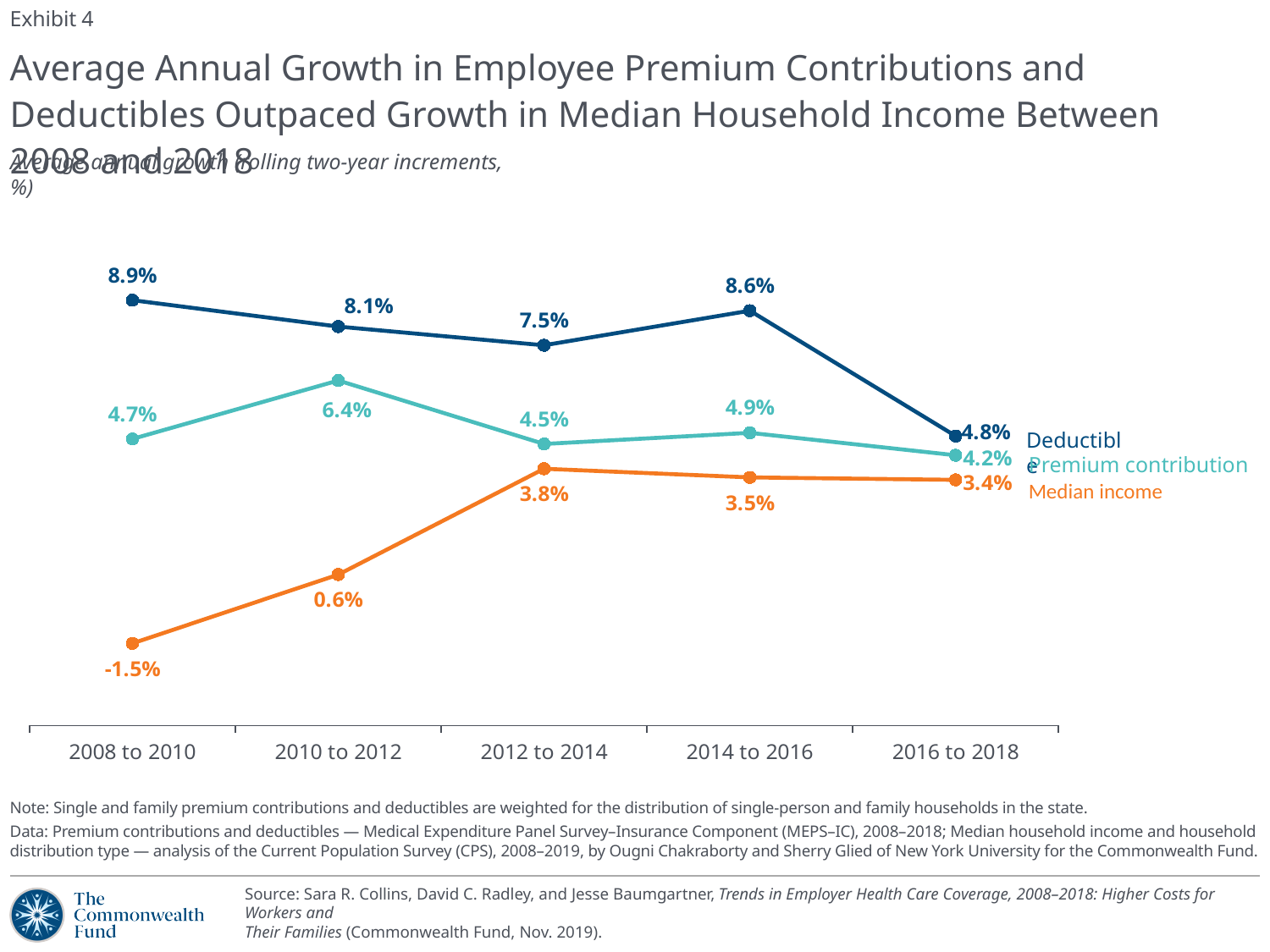
What is the difference between the Deductible value and the Median income value in 2016 to 2018? 1.4% In which period is the Deductible value lowest? 2016 to 2018 What is the value for Deductible in 2008 to 2010? 8.9% What is the value for Median income in 2010 to 2012? 0.6% What kind of chart is shown on the slide? Line chart How many series does the chart show? 3 In which period is the Premium contribution value highest? 2010 to 2012 Which is larger in 2012 to 2014, Premium contribution or Median income? Premium contribution How many periods are shown on the x axis? 5 Does the Median income series rise or fall from 2008 to 2010 through 2012 to 2014? Rise Which series is drawn in orange? Median income What is the value for Premium contribution in 2014 to 2016? 4.9%